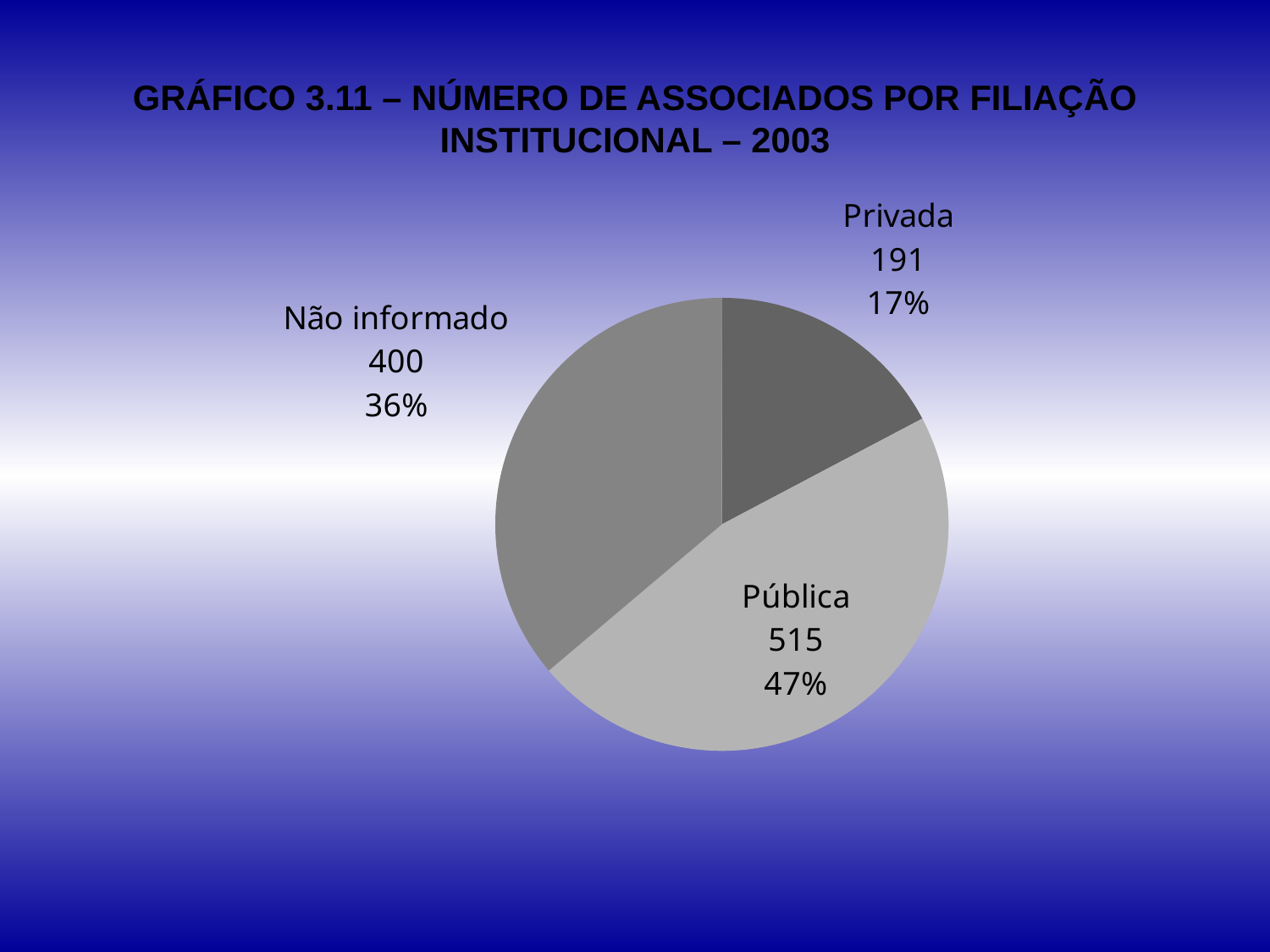
What share of the pie does the Não informado slice represent? 36% What is the number of associates for Não informado? 400 What kind of chart is shown on the slide? pie chart What is the number of associates for Pública? 515 What share of the pie does the Privada slice represent? 17% What is the difference between the values for Pública and Privada? 324 Which is larger, the value for Não informado or the value for Privada? Não informado What is the number of associates for Privada? 191 What year does the chart title refer to? 2003 How many slices does the pie chart have? 3 Which category has the largest slice? Pública Which category has the smallest slice? Privada